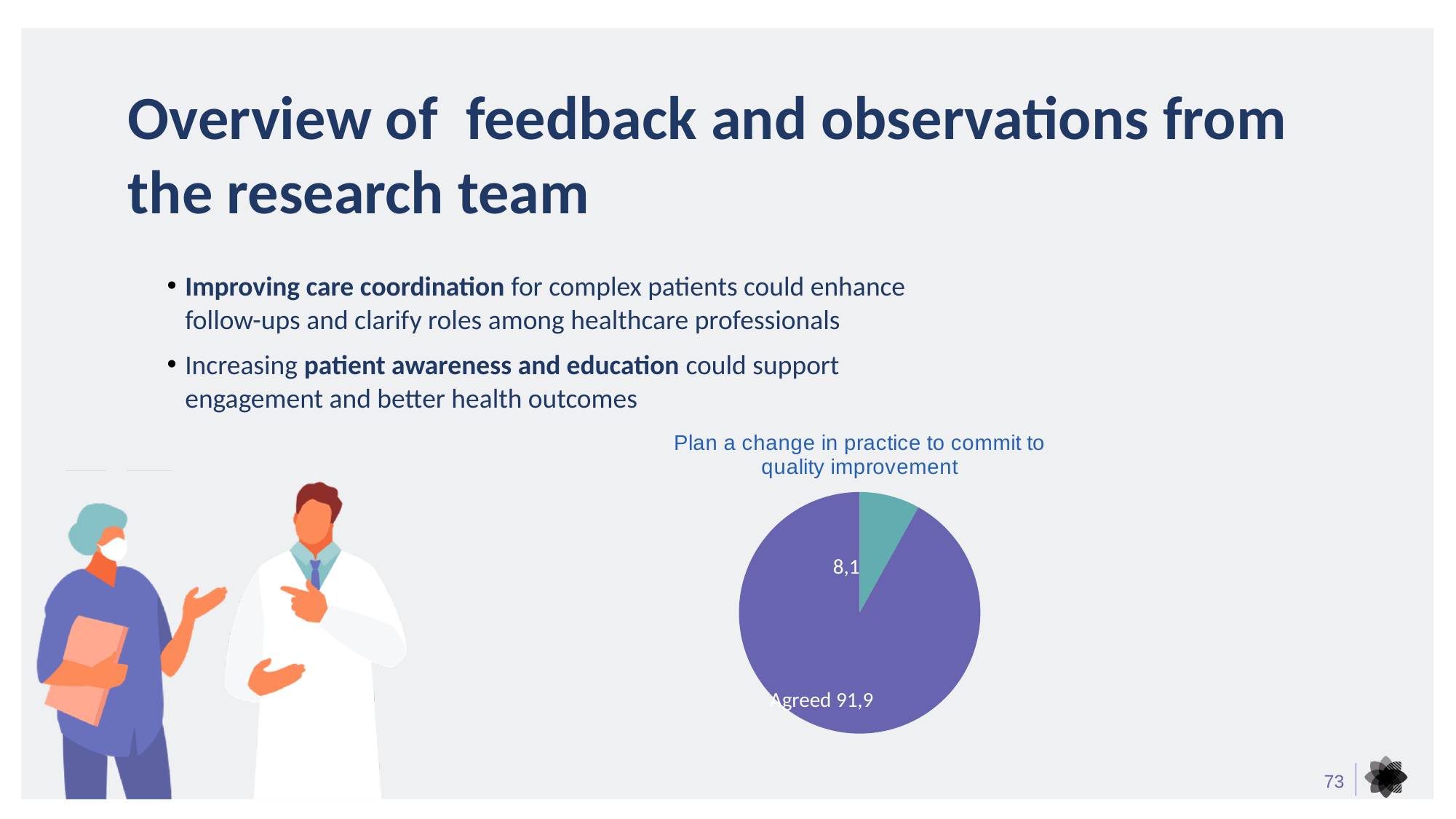
What kind of chart is shown on the slide? pie chart What colour is the "Agreed" slice in the pie chart? purple What is the difference between the two slice values in the pie chart? 83,8 How many slices does the pie chart have? 2 What is the total of the two slice values shown in the pie chart? 100 What is the title of the pie chart? Plan a change in practice to commit to quality improvement Which slice of the pie chart is the largest? Agreed What value is shown for the "Agreed" slice of the pie chart? 91,9 What value is shown on the smaller, teal slice of the pie chart? 8,1 Is the "Agreed" slice larger or smaller than the other slice in the pie chart? larger